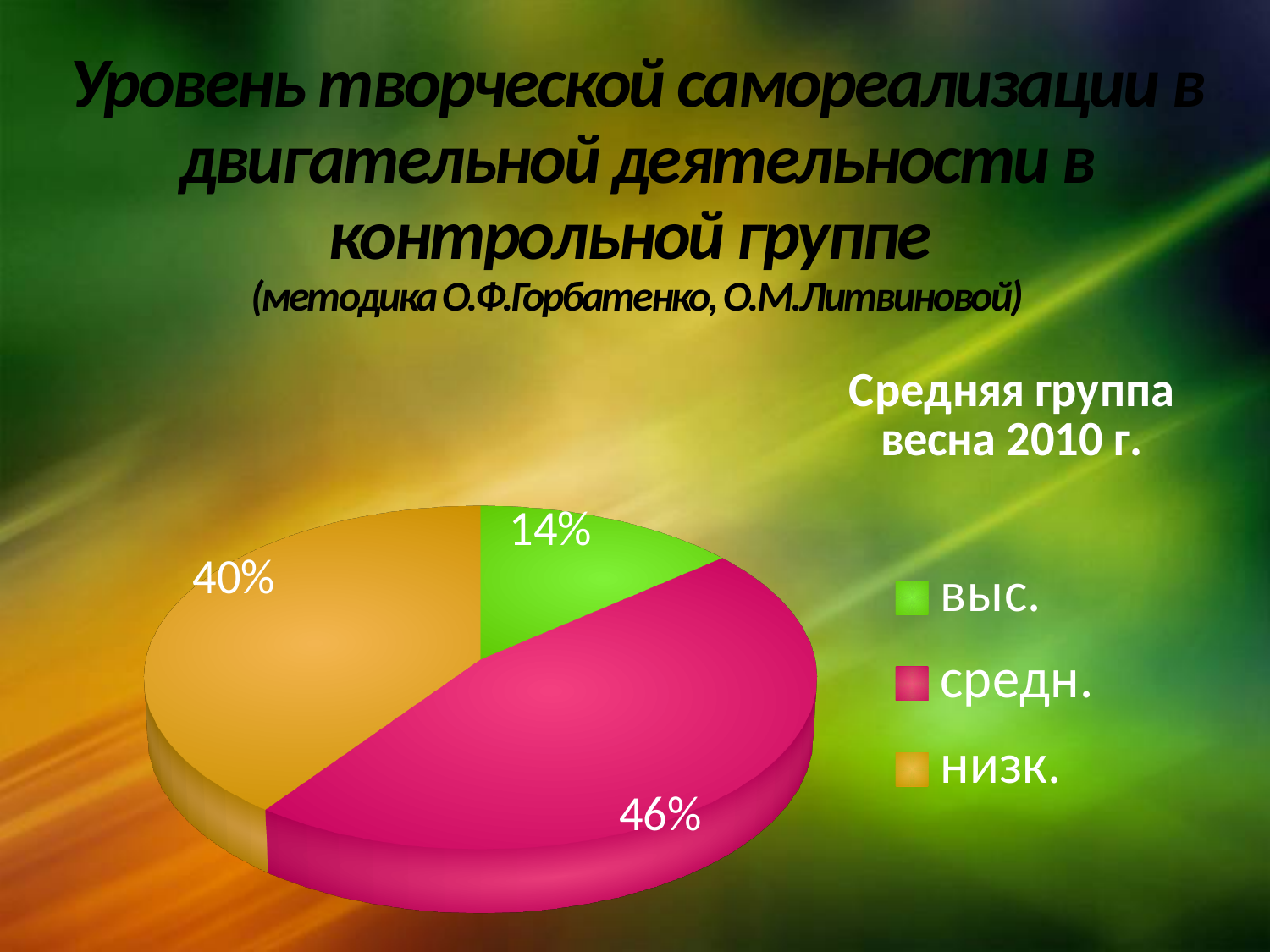
What kind of chart is shown on the slide? pie chart Which category has the largest share of the pie? средн. What is the difference between the "средн." and "низк." slices? 6% What is the value for the "низк." slice? 40% What is the title of the chart? Средняя группа весна 2010 г. What is the value for the "выс." slice? 14% Which is larger, the "выс." slice or the "низк." slice? низк. What is the difference between the "низк." and "выс." slices? 26% What is the value for the "средн." slice? 46% How many slices does the pie chart have? 3 Which category has the smallest share of the pie? выс. What colour is the "средн." slice? pink